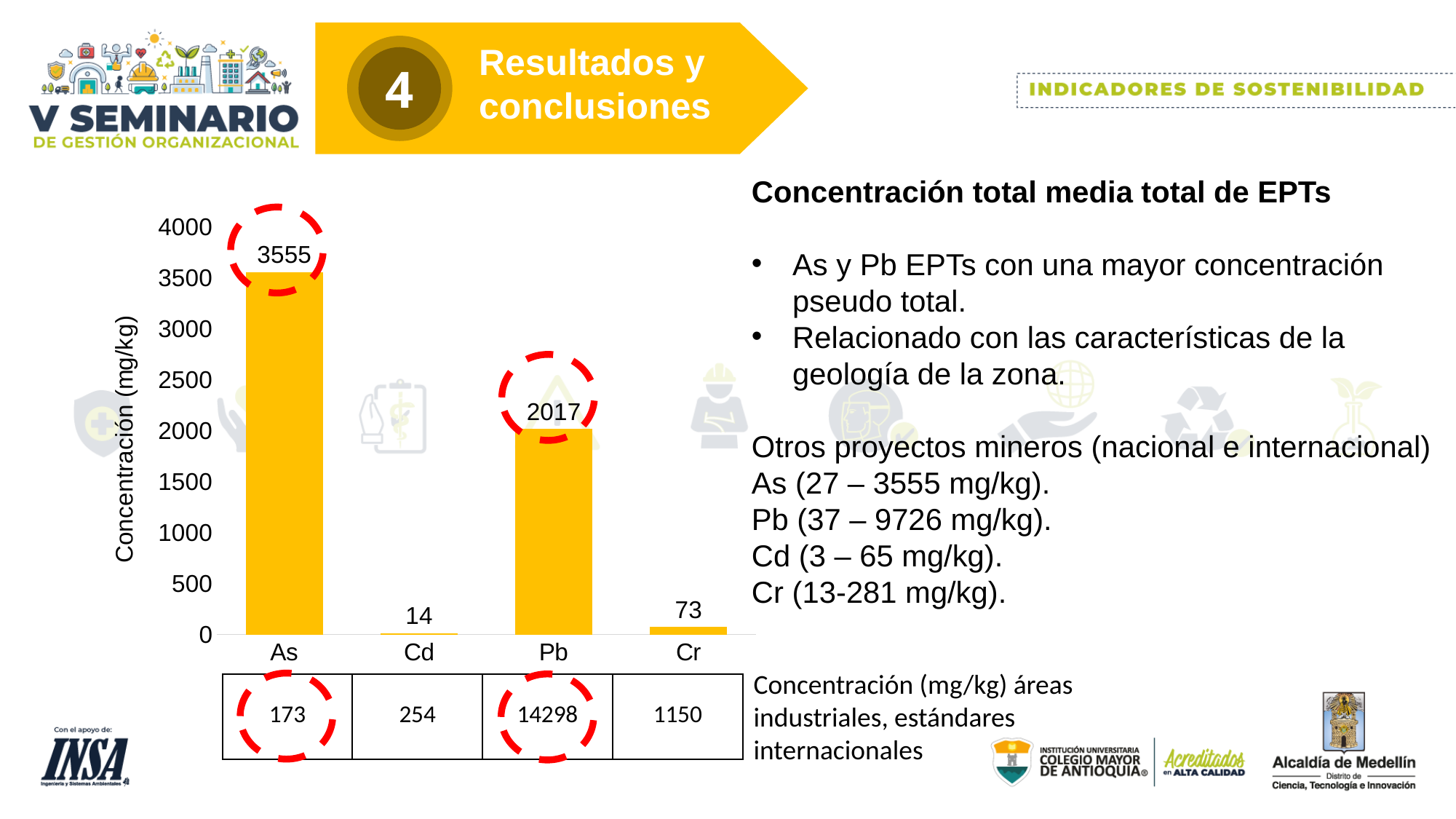
Which has a larger concentration in the bar chart, Cr or Cd? Cr What is the concentration value shown for Pb in the bar chart? 2017 What is the concentration value shown for Cd in the bar chart? 14 How many elements (categories) are plotted in the bar chart? 4 Is the value for Pb in the bar chart greater or less than 2500? less What is the label of the vertical axis of the bar chart? Concentración (mg/kg) What is the difference between the concentration values for As and Pb in the bar chart? 1538 What is the concentration value shown for As in the bar chart? 3555 What is the concentration value shown for Cr in the bar chart? 73 Which element has the highest concentration in the bar chart? As What type of chart is used to show the concentrations of As, Cd, Pb and Cr? bar chart Which element has the lowest concentration in the bar chart? Cd